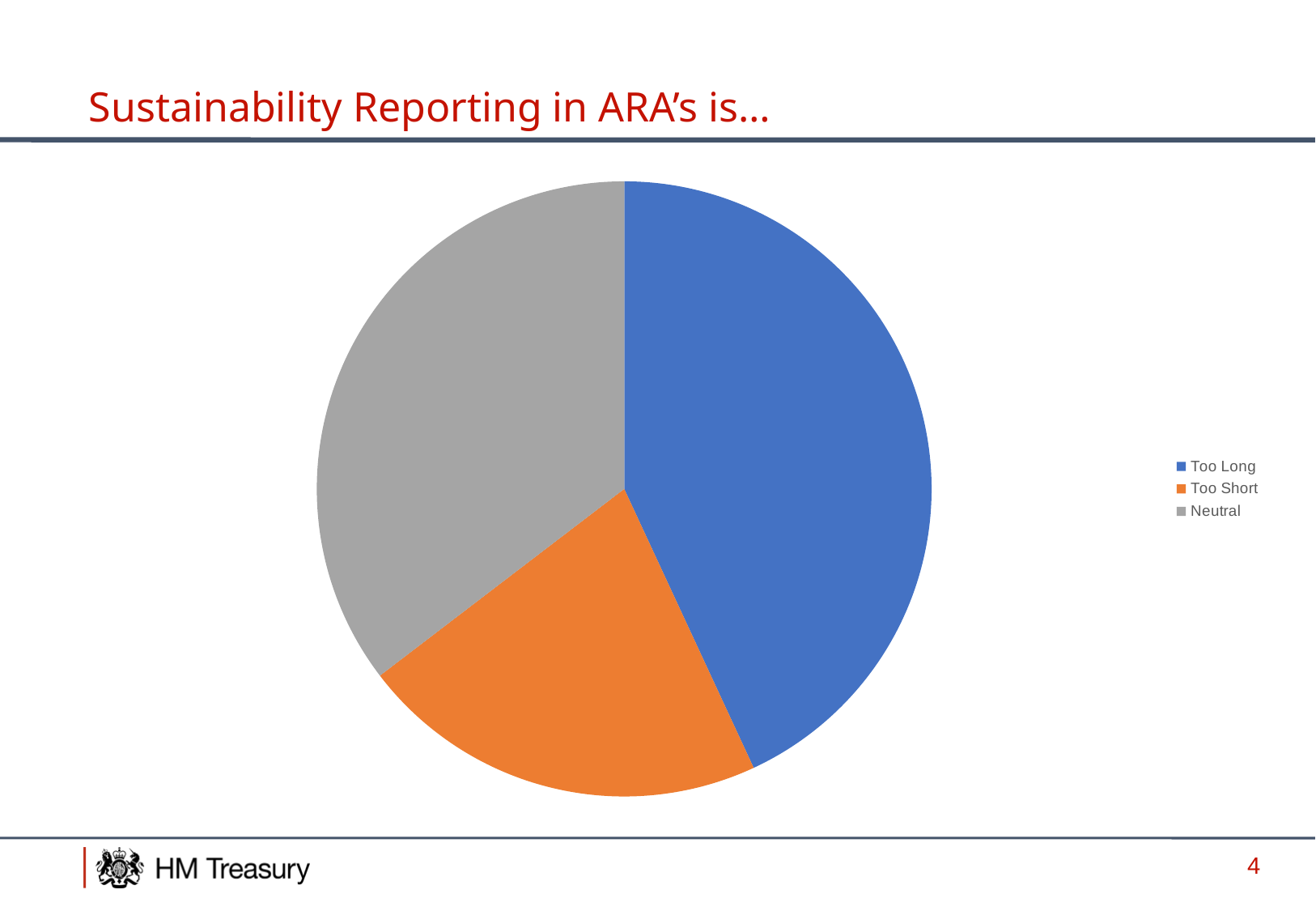
Which category has the largest slice of the pie? Too Long What kind of chart is shown on the slide? Pie chart What colour is the Neutral slice in the pie chart? Grey Which slice is larger, Too Long or Neutral? Too Long Which slice is larger, Neutral or Too Short? Neutral What is the title of the slide containing the pie chart? Sustainability Reporting in ARA's is... Which slice is larger, Too Short or Too Long? Too Long Which category has the smallest slice of the pie? Too Short How many slices does the pie chart have? 3 How many entries does the legend list? 3